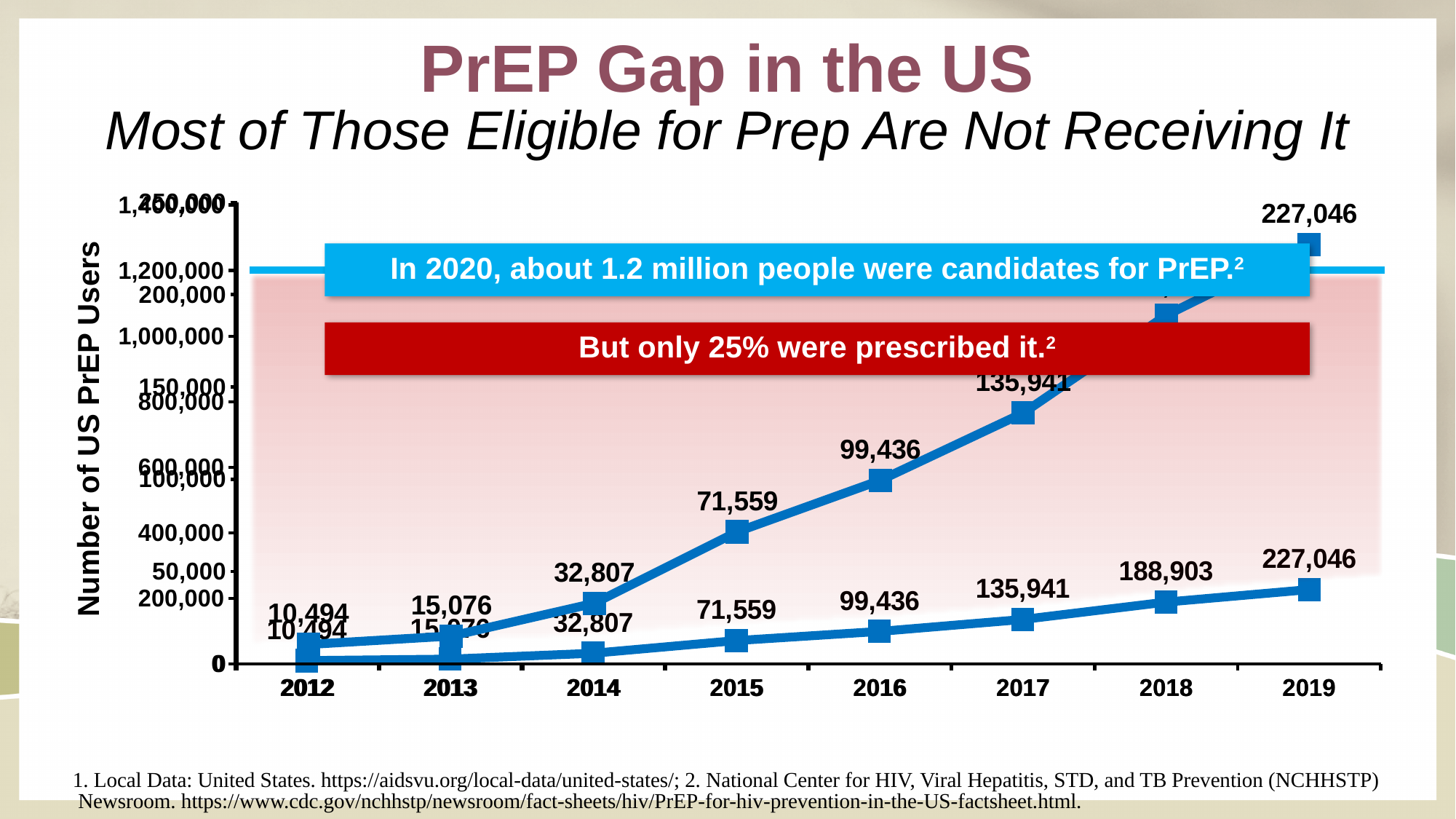
Which year had more US PrEP users, 2017 or 2015? 2017 What was the number of US PrEP users in 2018? 188,903 What is the difference in the number of US PrEP users between 2015 and 2014? 38,752 What was the number of US PrEP users in 2019? 227,046 What was the number of US PrEP users in 2012? 10,494 Which year has the highest number of US PrEP users? 2019 What was the number of US PrEP users in 2016? 99,436 How many years are plotted on the x axis of the chart? 8 What is the difference in the number of US PrEP users between 2019 and 2018? 38,143 What type of chart is used to show the number of US PrEP users? line chart Which year has the lowest number of US PrEP users? 2012 Does the number of US PrEP users rise or fall from 2012 to 2019? rise